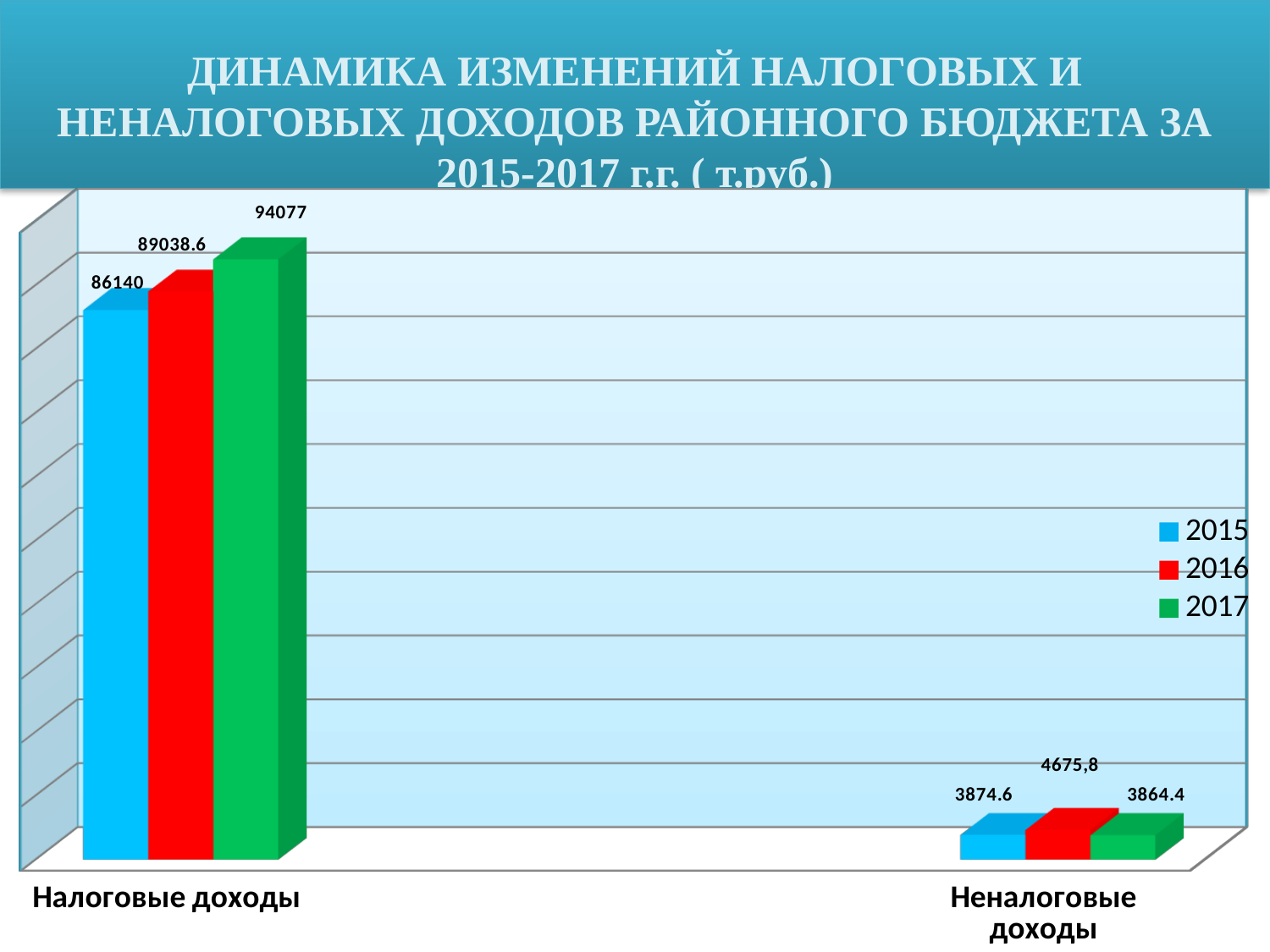
Which year has the highest value for Неналоговые доходы? 2016 Which is larger for Налоговые доходы: the 2016 value or the 2017 value? 2017 What is the value for Неналоговые доходы in 2016? 4675,8 What kind of chart is shown on the slide? Bar chart Which year has the highest value for Налоговые доходы? 2017 What is the value for Неналоговые доходы in 2017? 3864.4 What is the value for Налоговые доходы in 2017? 94077 Which year has the lowest value for Налоговые доходы? 2015 How many series does the legend list? 3 What is the difference between the 2017 and 2015 values for Налоговые доходы? 7937 How many categories are shown on the x axis? 2 What is the value for Налоговые доходы in 2015? 86140